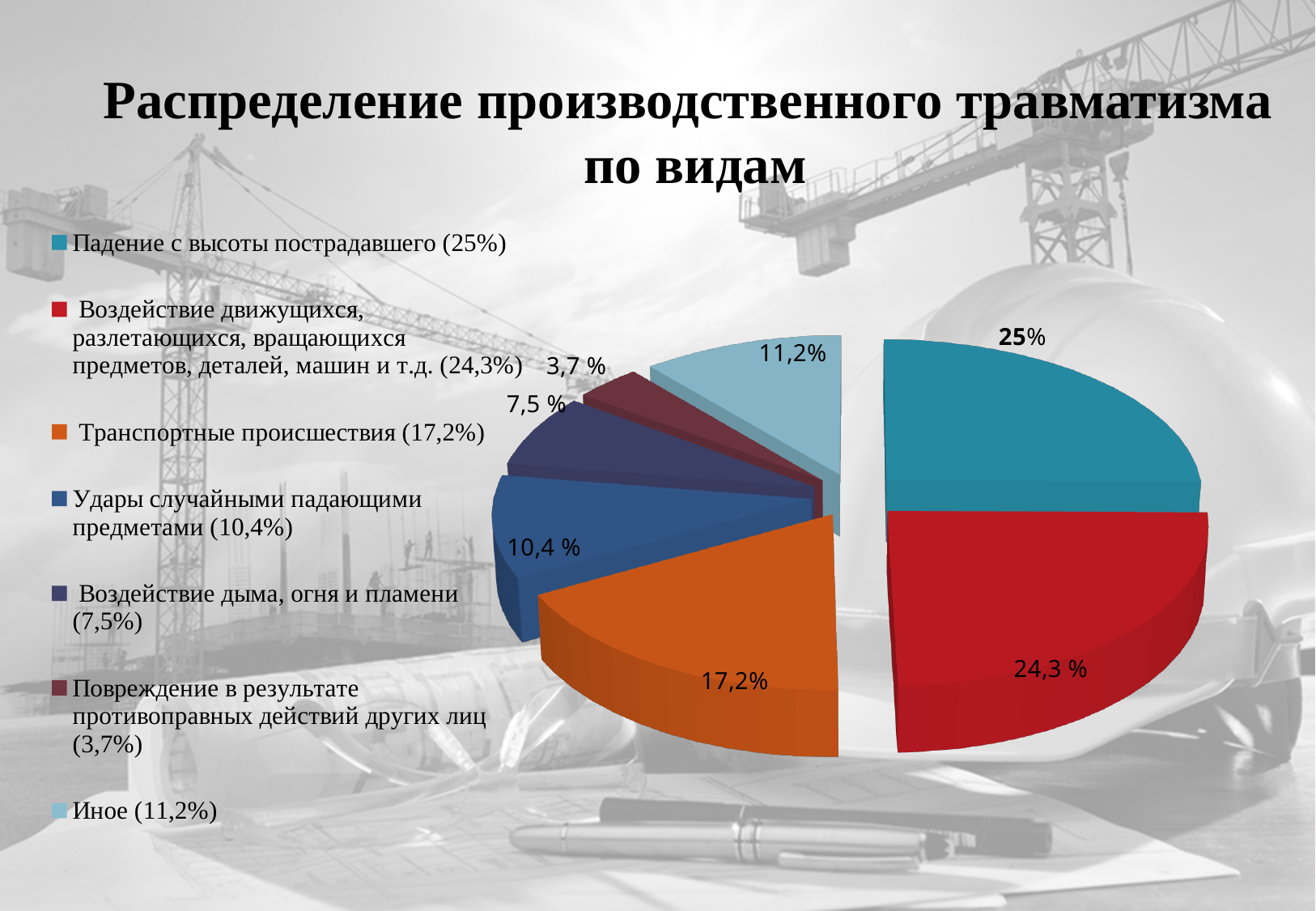
What is the difference between the shares for Иное and Повреждение в результате противоправных действий других лиц? 7,5% How many slices does the pie chart have? 7 Which category has the largest slice of the pie? Падение с высоты пострадавшего Which is larger: the share for Удары случайными падающими предметами or the share for Иное? Иное Which category has the smallest slice of the pie? Повреждение в результате противоправных действий других лиц What kind of chart is shown on the slide? Pie chart What share of the pie is labelled for Падение с высоты пострадавшего? 25% What is the difference between the shares for Транспортные происшествия and Удары случайными падающими предметами? 6,8% What value is shown for Воздействие дыма, огня и пламени? 7,5 % What colour is the slice for Транспортные происшествия? Orange What value is shown for Иное? 11,2% What value is shown for Транспортные происшествия? 17,2%